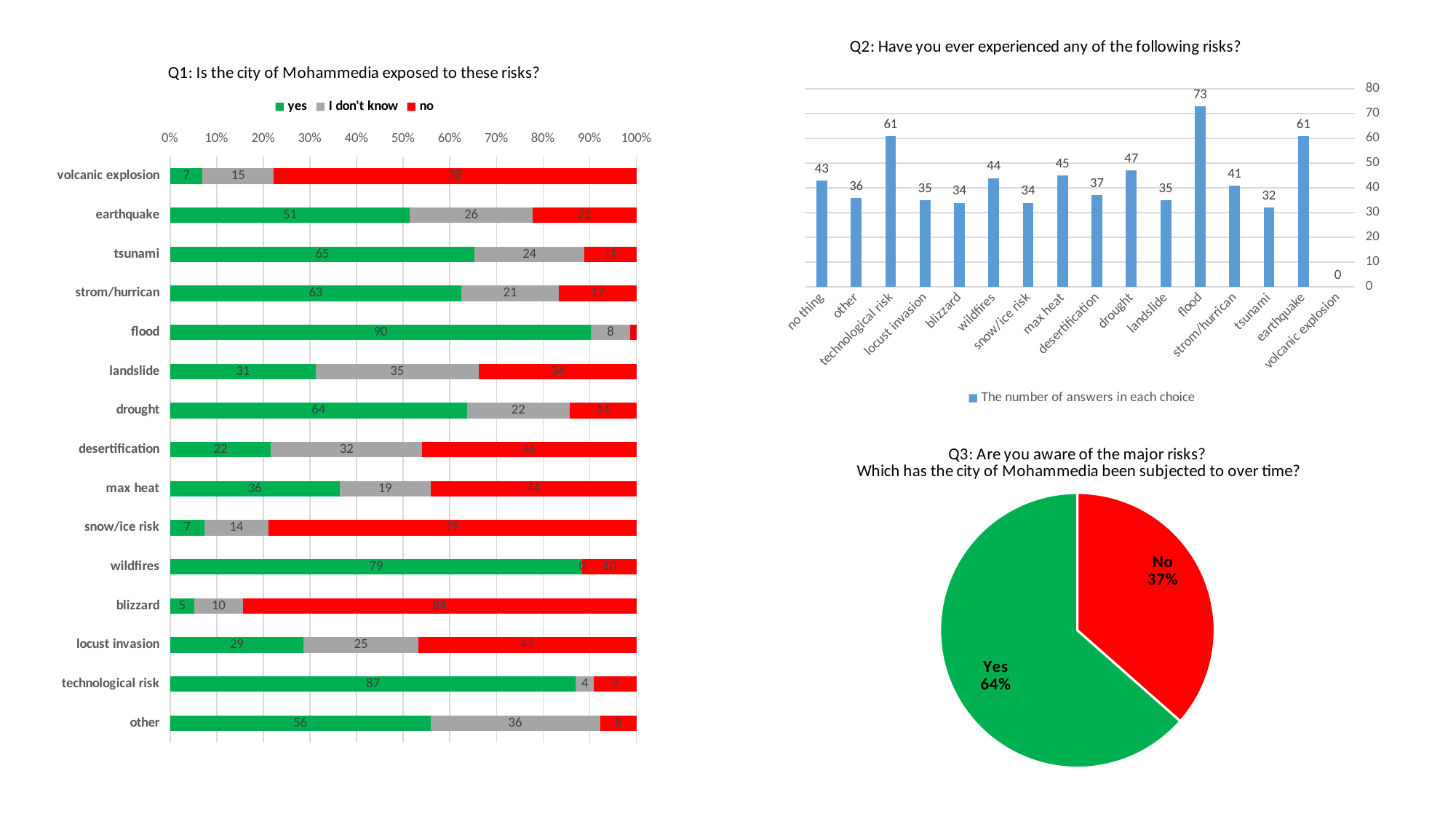
In the Q2 chart, which has more answers, wildfires or max heat? max heat How many series does the legend of the Q1 chart list? 3 In the Q1 chart, what is the 'no' value for blizzard? 84 How many risk categories are shown in the Q1 chart? 15 In the Q1 chart, what is the 'I don't know' value for landslide? 35 In the Q1 chart, what is the 'yes' value for flood? 90 In the Q3 pie chart, what share of respondents answered Yes? 64% In the Q2 chart, which risk has the highest number of answers? flood What kind of chart is the Q3 chart? pie chart In the Q2 chart, what is the value for volcanic explosion? 0 In the Q2 chart, how many answers are there for drought? 47 In the Q2 chart, what is the difference between the number of answers for flood and for tsunami? 41